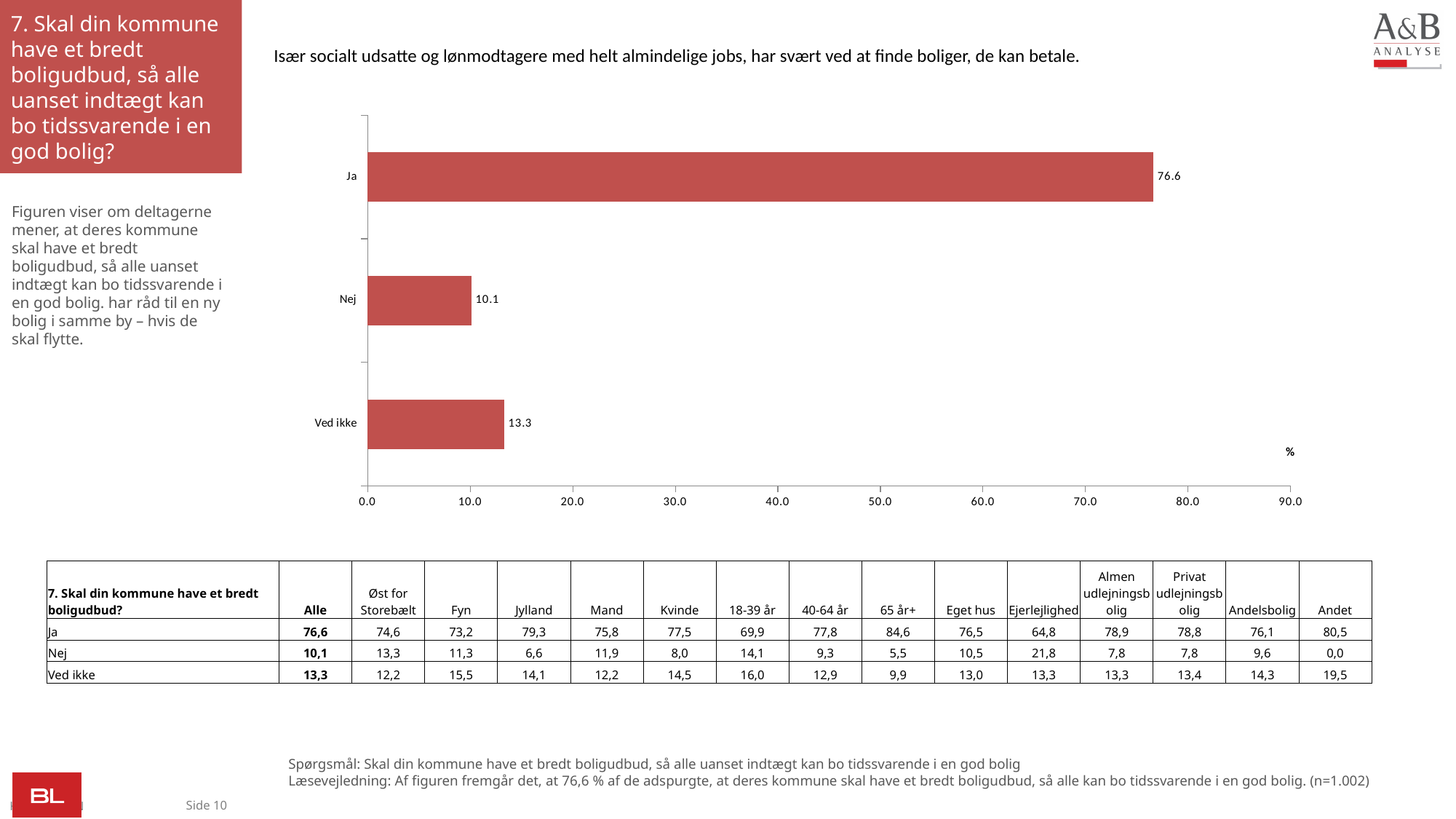
What is the value for "Ja"? 76.6 Which category has the highest value? Ja Which category has the lowest value? Nej What is the value for "Nej"? 10.1 Which is larger, the value for "Nej" or the value for "Ved ikke"? Ved ikke What is the highest tick value shown on the horizontal axis? 90.0 Is the value for "Ja" greater or less than 70.0? greater What is the difference between the values for "Ja" and "Ved ikke"? 63.3 What is the difference between the values for "Ved ikke" and "Nej"? 3.2 What is the value for "Ved ikke"? 13.3 How many categories are shown in the chart? 3 What kind of chart is shown on the slide? bar chart